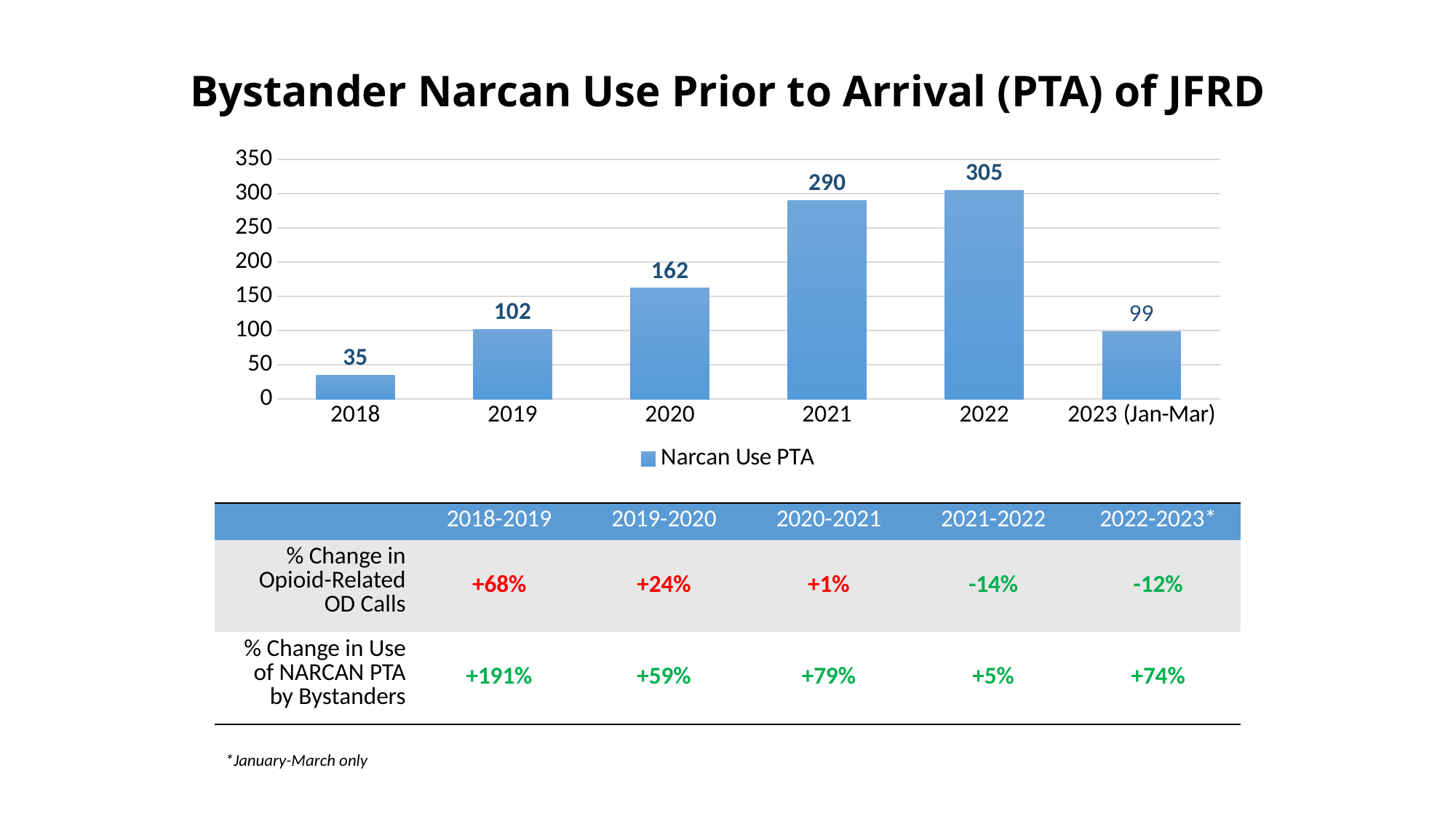
Which year has the highest Narcan Use PTA value? 2022 What is the Narcan Use PTA value for 2023 (Jan-Mar)? 99 What is the Narcan Use PTA value for 2018? 35 Which is larger, the Narcan Use PTA value for 2019 or for 2023 (Jan-Mar)? 2019 How many categories are shown on the x axis of the chart? 6 What kind of chart is shown on the slide? bar chart What is the difference between the Narcan Use PTA values for 2020 and 2019? 60 What is the Narcan Use PTA value for 2021? 290 Is the Narcan Use PTA value for 2020 greater or less than 150? greater What is the difference between the Narcan Use PTA values for 2022 and 2021? 15 Which year has the lowest Narcan Use PTA value? 2018 What is the title of the chart? Bystander Narcan Use Prior to Arrival (PTA) of JFRD